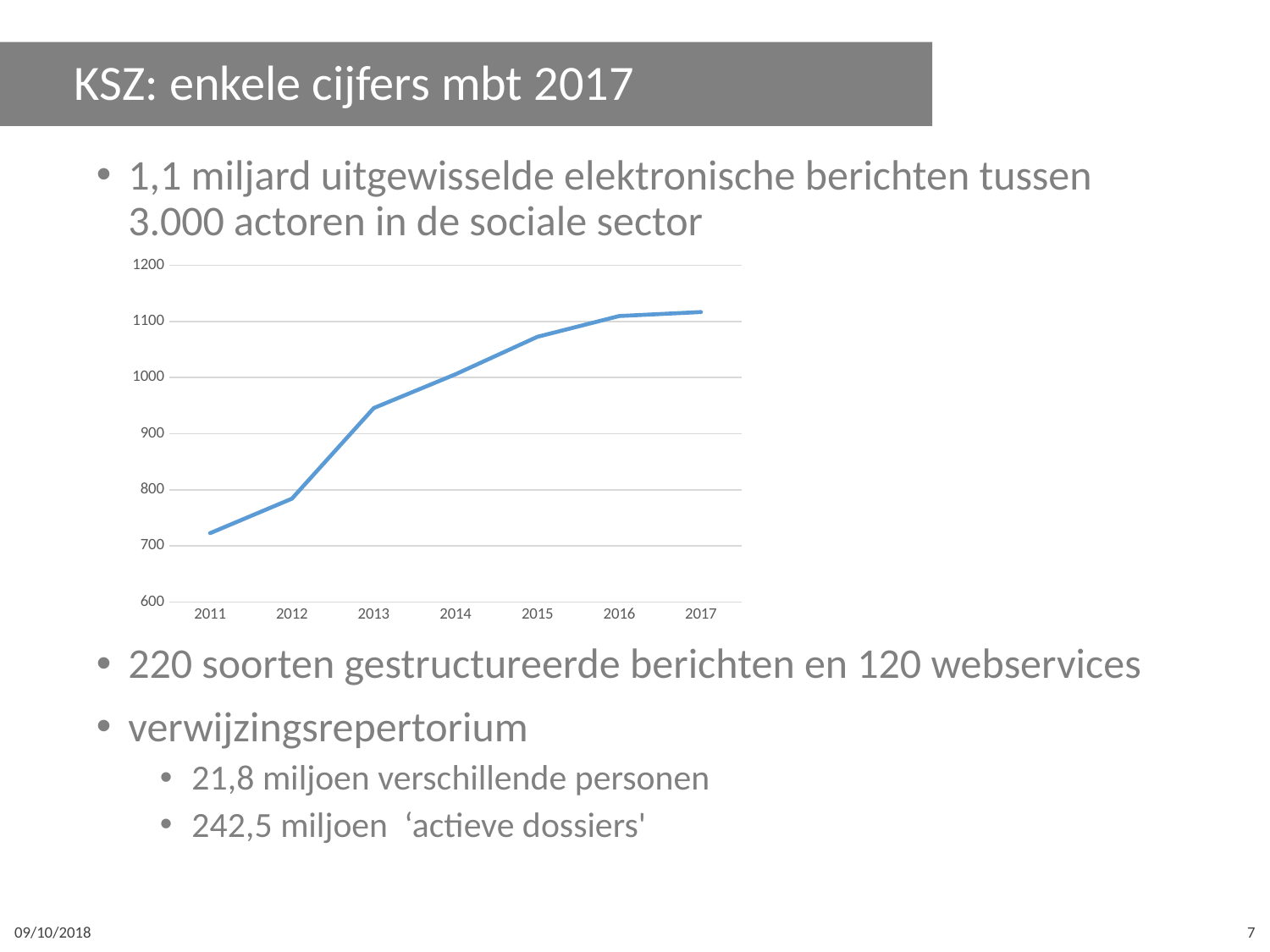
What is the lowest value shown on the y axis of the chart? 600 Which year has the lowest value in the chart? 2011 Is the value for 2014 greater or less than 1100? less Is the value for 2013 greater or less than 900? greater What kind of chart is shown on the slide? line chart Is the value for 2011 greater or less than 800? less How many years are plotted along the x axis of the chart? 7 Which is larger, the value for 2013 or the value for 2012? 2013 Do the values in the chart rise or fall from 2011 to 2017? rise